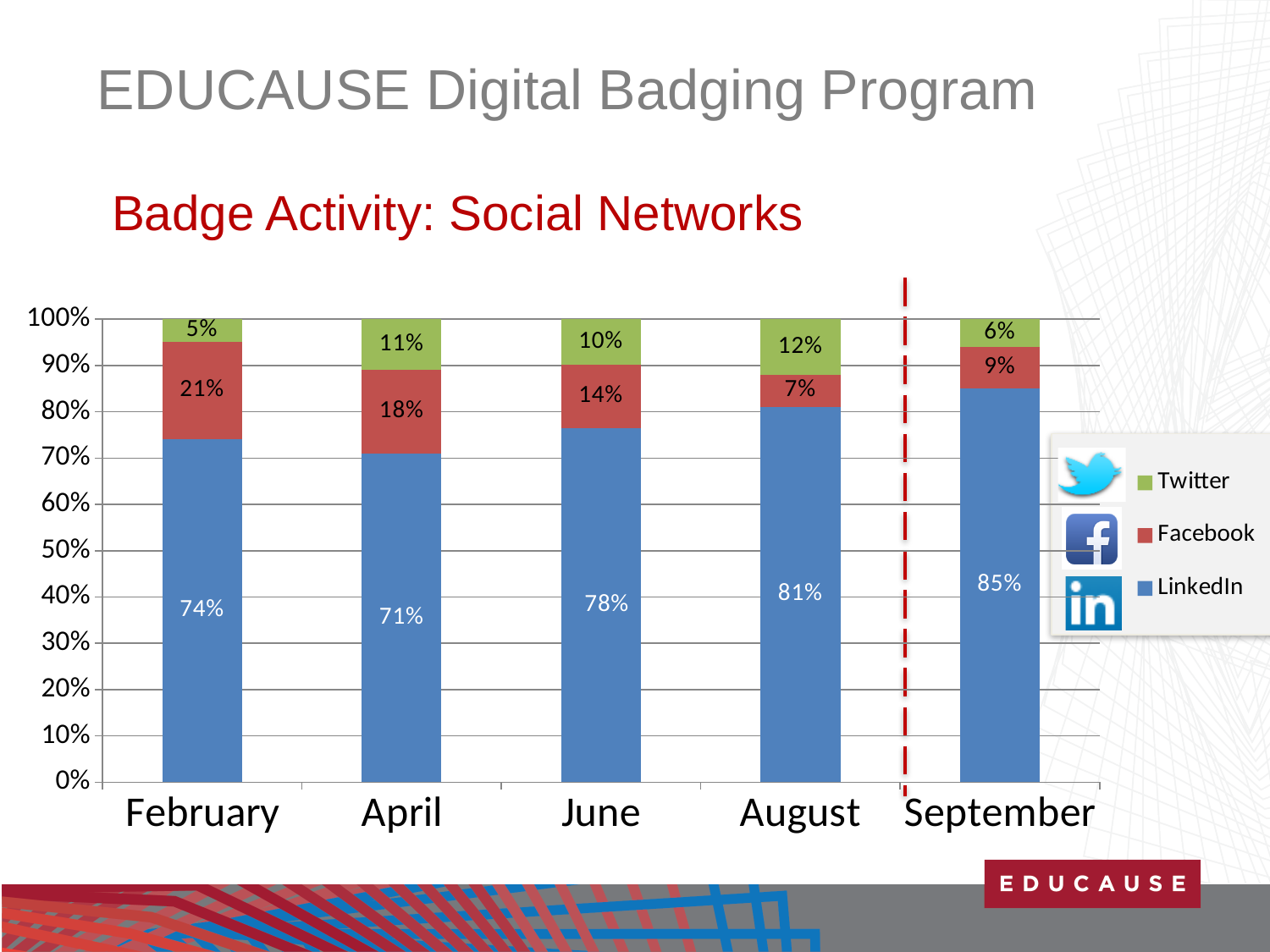
What is the difference between the Facebook values for February and September? 12% Is the LinkedIn value larger in June or in April? June What is the Twitter value for August? 12% What kind of chart is shown? Stacked bar chart What is the Facebook value for April? 18% What is the LinkedIn value for September? 85% How many months are shown on the x axis? 5 Which month has the lowest Twitter value? February How many series does the legend list? 3 Which series is shown in green? Twitter What is the LinkedIn value for February? 74% Which month has the highest LinkedIn value? September